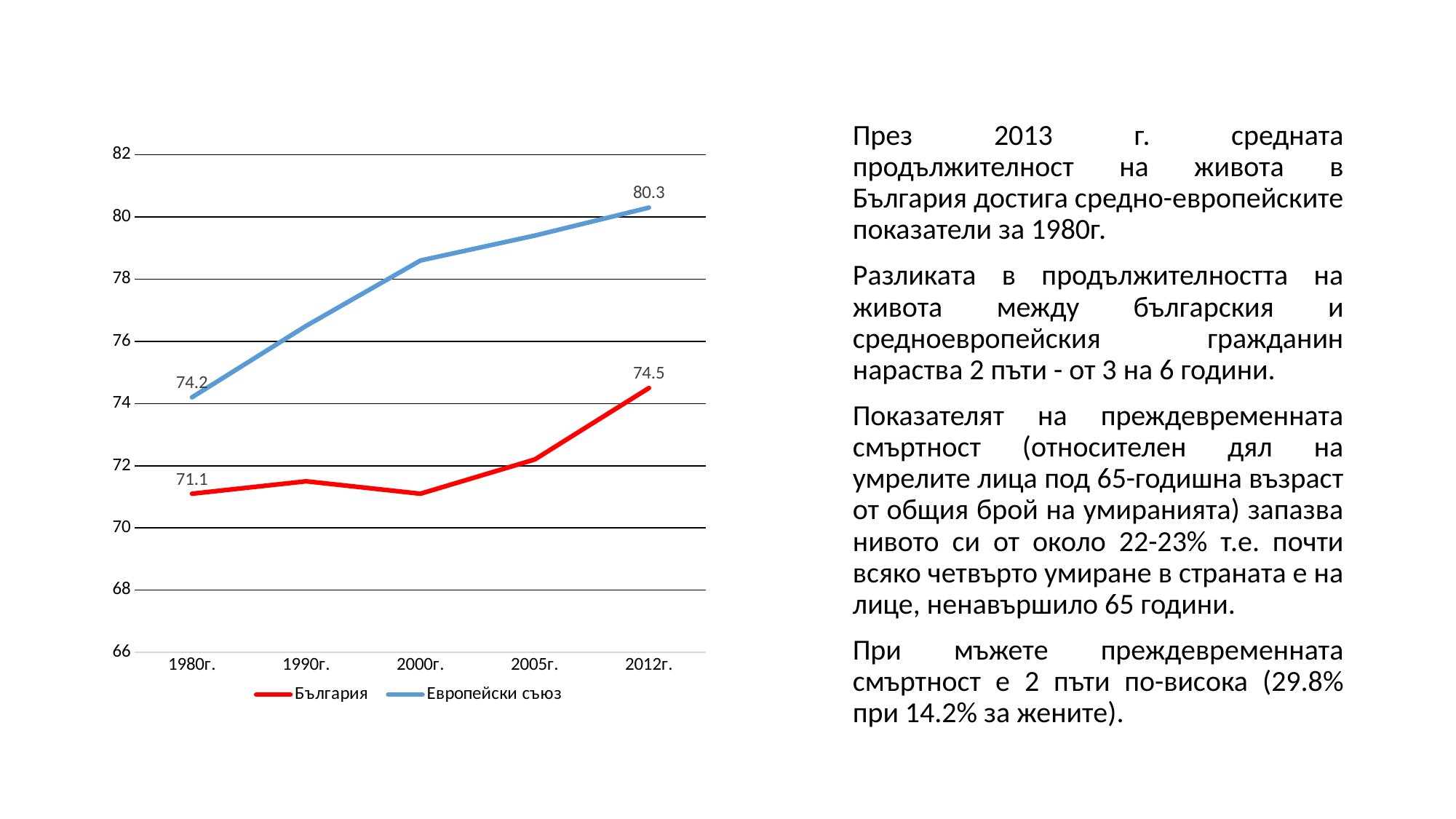
What is the value for Европейски съюз in 2012г.? 80.3 What is the value for Европейски съюз in 1980г.? 74.2 What is the difference between the Европейски съюз and България values in 2012г.? 5.8 What is the value for България in 2012г.? 74.5 How many years are shown on the x axis of the chart? 5 What kind of chart is shown on the slide? line chart How many series does the legend list? 2 By how much did the value for Европейски съюз increase from 1980г. to 2012г.? 6.1 What is the value for България in 1980г.? 71.1 Is the value for България in 2000г. greater or less than 72? less Is the value for Европейски съюз in 2000г. greater or less than 78? greater In 1980г., which series has the higher value, България or Европейски съюз? Европейски съюз